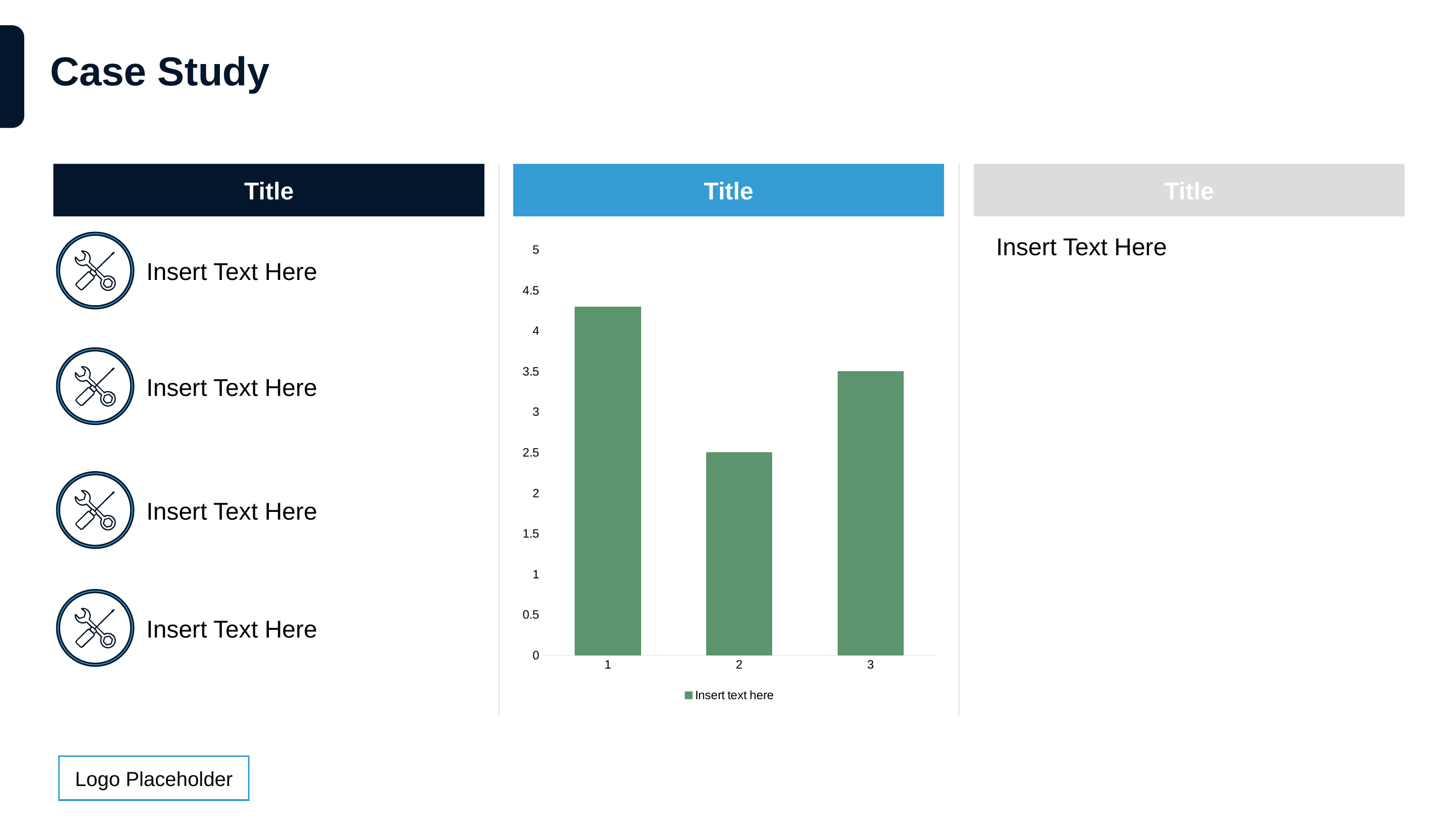
What is the value of the bar for category 3? 3.5 Which category has the lowest bar? 2 Which is larger, the bar for category 1 or the bar for category 3? 1 What is the legend entry shown below the chart? Insert text here What type of chart is shown on the slide? bar chart What is the value of the bar for category 2? 2.5 What is the difference between the values for category 3 and category 2? 1 How many bars (categories) does the chart show? 3 Which category has the highest bar? 1 How many series does the chart legend list? 1 Is the value for category 1 greater or less than 4? greater Is the value for category 2 greater or less than 3? less